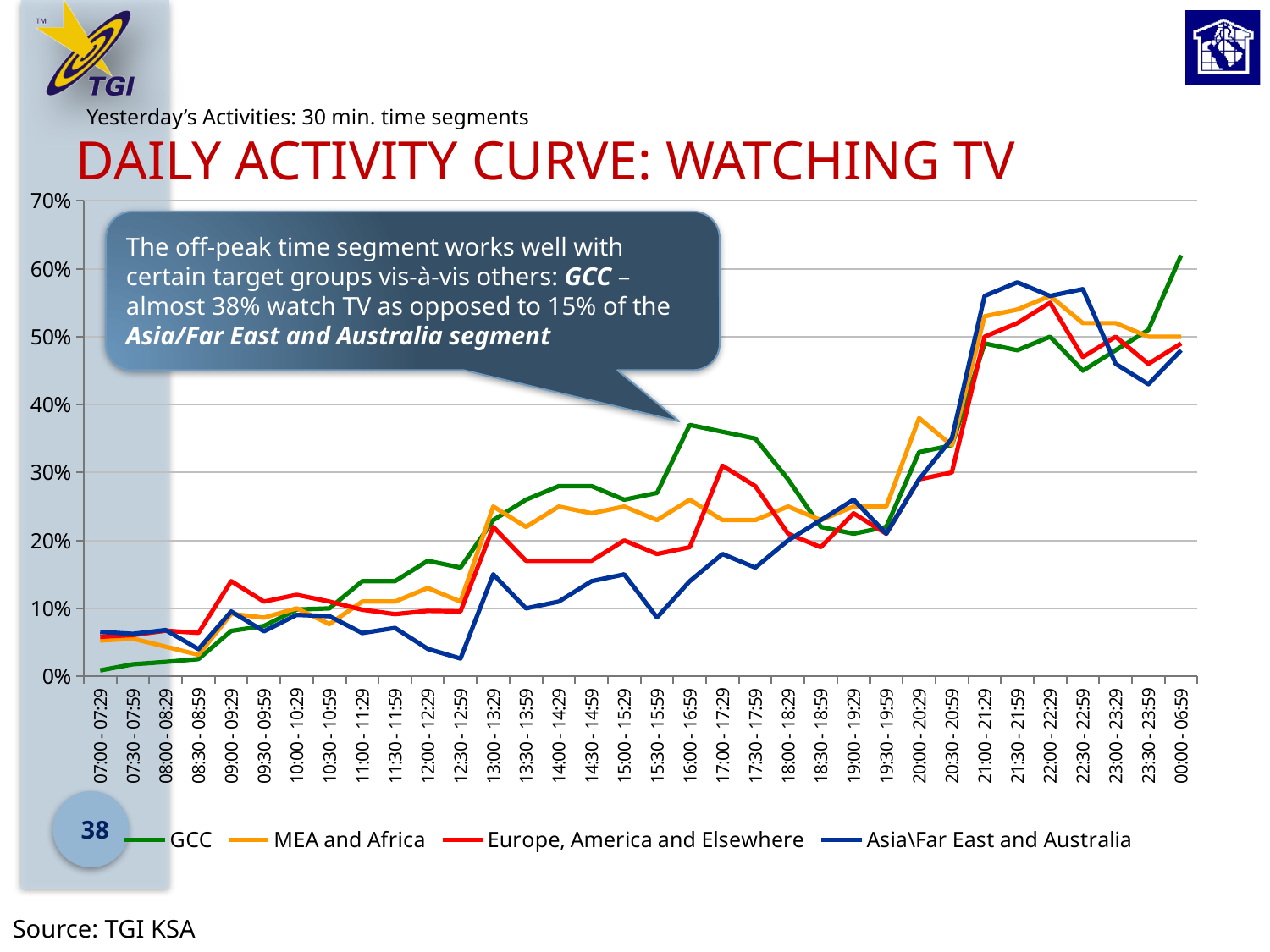
In the 21:30 - 21:59 segment, which is larger: GCC or Asia\Far East and Australia? Asia\Far East and Australia Is the value for Asia\Far East and Australia in the 12:30 - 12:59 segment greater or less than 10%? less Is the value for MEA and Africa in the 20:00 - 20:29 segment greater or less than 30%? greater How many series does the legend list? 4 Which series has the highest value in the 00:00 - 06:59 segment? GCC Which series has the lowest value in the 07:00 - 07:29 segment? GCC Overall, does the GCC line rise or fall from the 07:00 - 07:29 segment to the 00:00 - 06:59 segment? Rise What type of chart is shown on the slide? Line chart Is the value for GCC in the 00:00 - 06:59 segment greater or less than 60%? greater How many time segments are plotted along the x axis? 34 What is the title of the chart? DAILY ACTIVITY CURVE: WATCHING TV